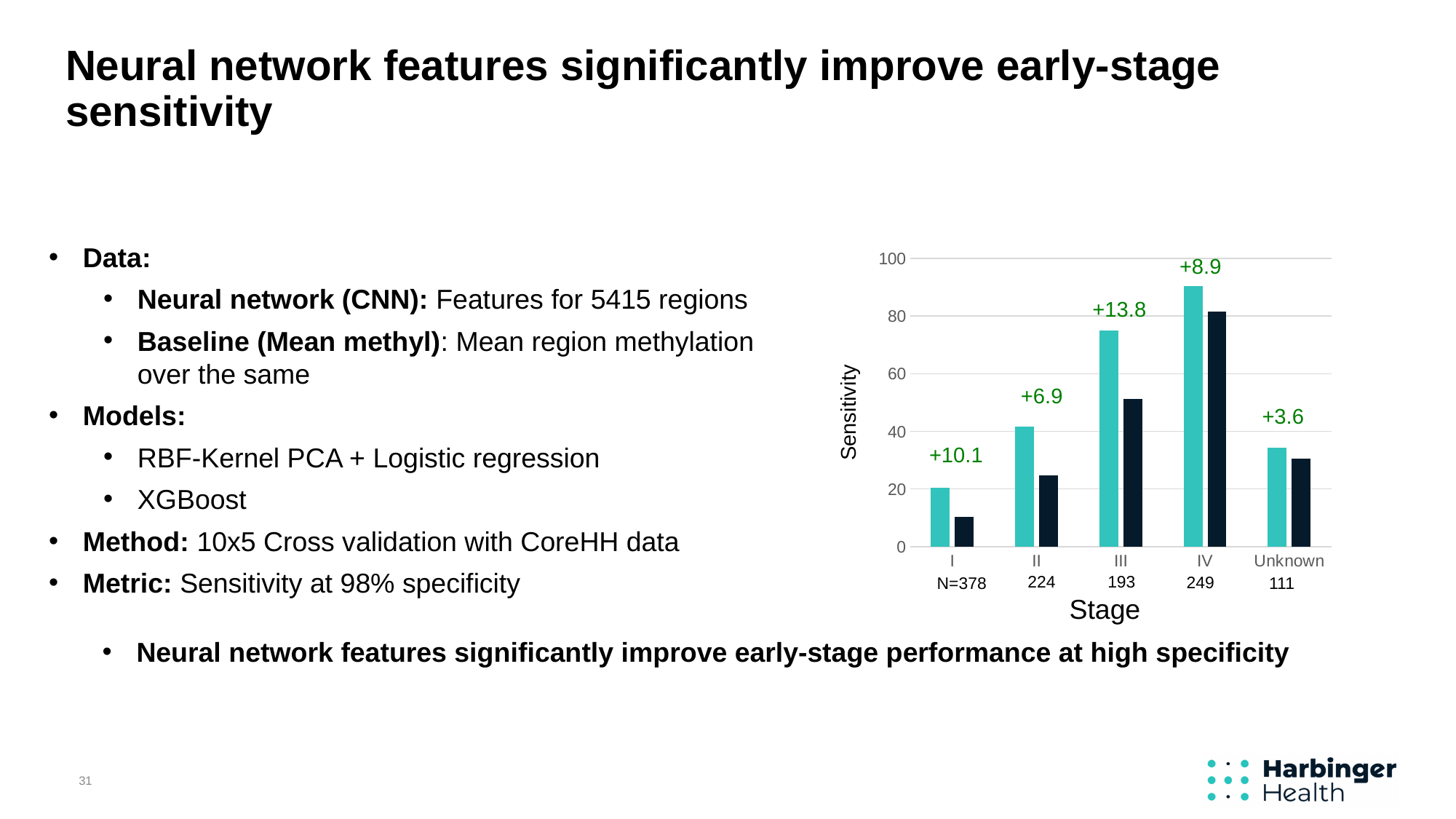
What kind of chart is shown on the slide? bar chart What sample size (N) is shown under stage II? 224 Which stage has the largest printed improvement value? III What improvement value is printed above the bars for stage III? +13.8 Do the teal bars rise or fall from stage I to stage IV? rise Is the dark bar for stage I greater or less than 20? less What is the label on the y axis of the chart? Sensitivity Which stage has the tallest teal bar? IV How many stage categories are shown on the x axis of the chart? 5 Is the teal bar for stage IV greater or less than 80? greater What improvement value is printed above the bars for stage I? +10.1 Which stage has the smallest printed improvement value? Unknown